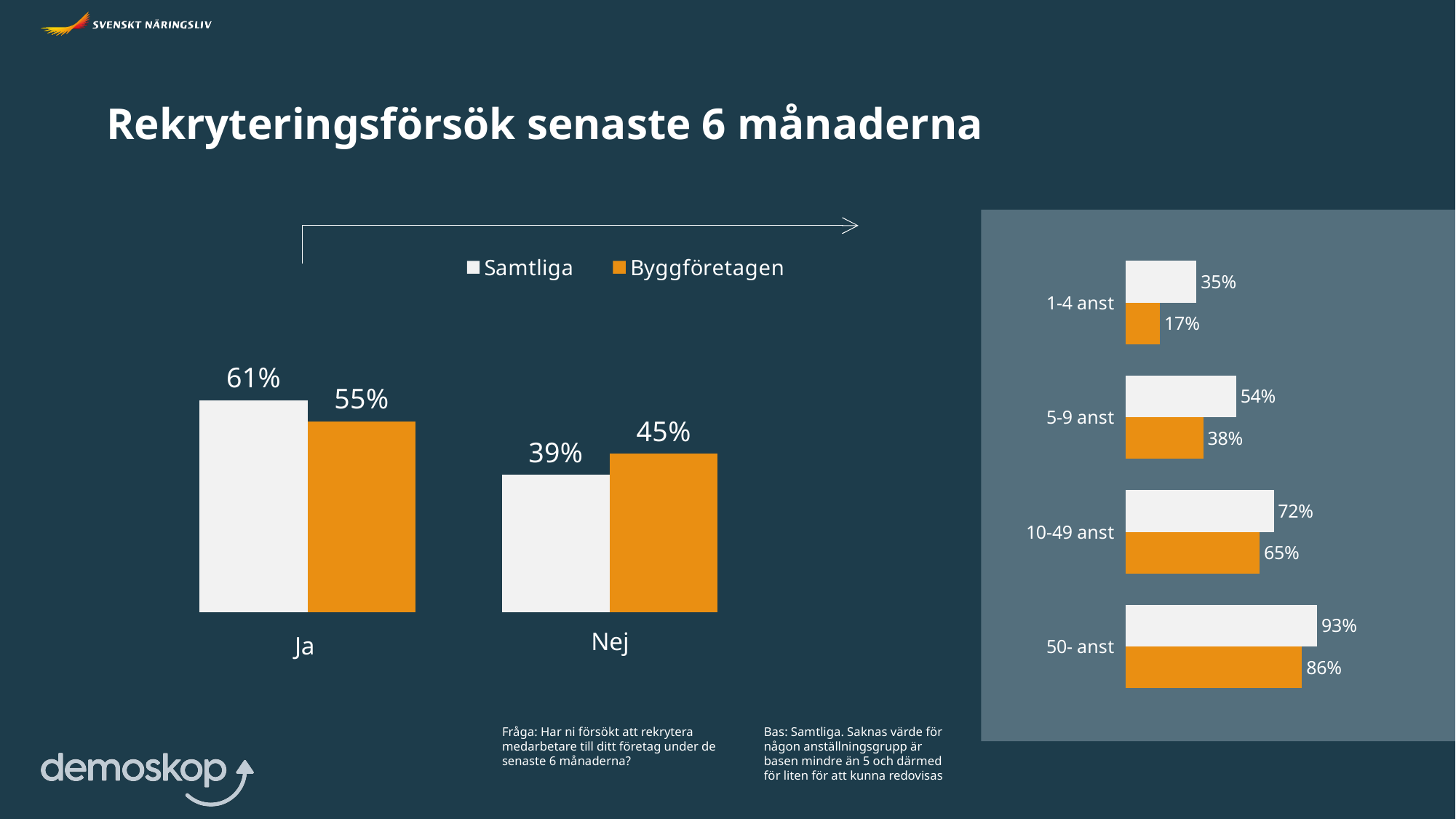
How many company size categories are shown in the right chart? 4 In the left chart, what is the difference between Samtliga and Byggföretagen for Ja? 6% What kind of chart is the left chart? Bar chart In the right chart, which company size group has the highest white bar value? 50- anst In the right chart, what is the value of the white bar for 10-49 anst? 72% In the right chart, what is the value of the orange bar for 1-4 anst? 17% In the left chart, what is the value for Byggföretagen in the Nej category? 45% In the left chart, how many series does the legend list? 2 In the right chart, which company size group has the lowest orange bar value? 1-4 anst In the right chart, what is the difference between the white and orange bars for 5-9 anst? 16% In the left chart, which is larger for Nej: Samtliga or Byggföretagen? Byggföretagen In the left chart, what is the value for Samtliga in the Ja category? 61%